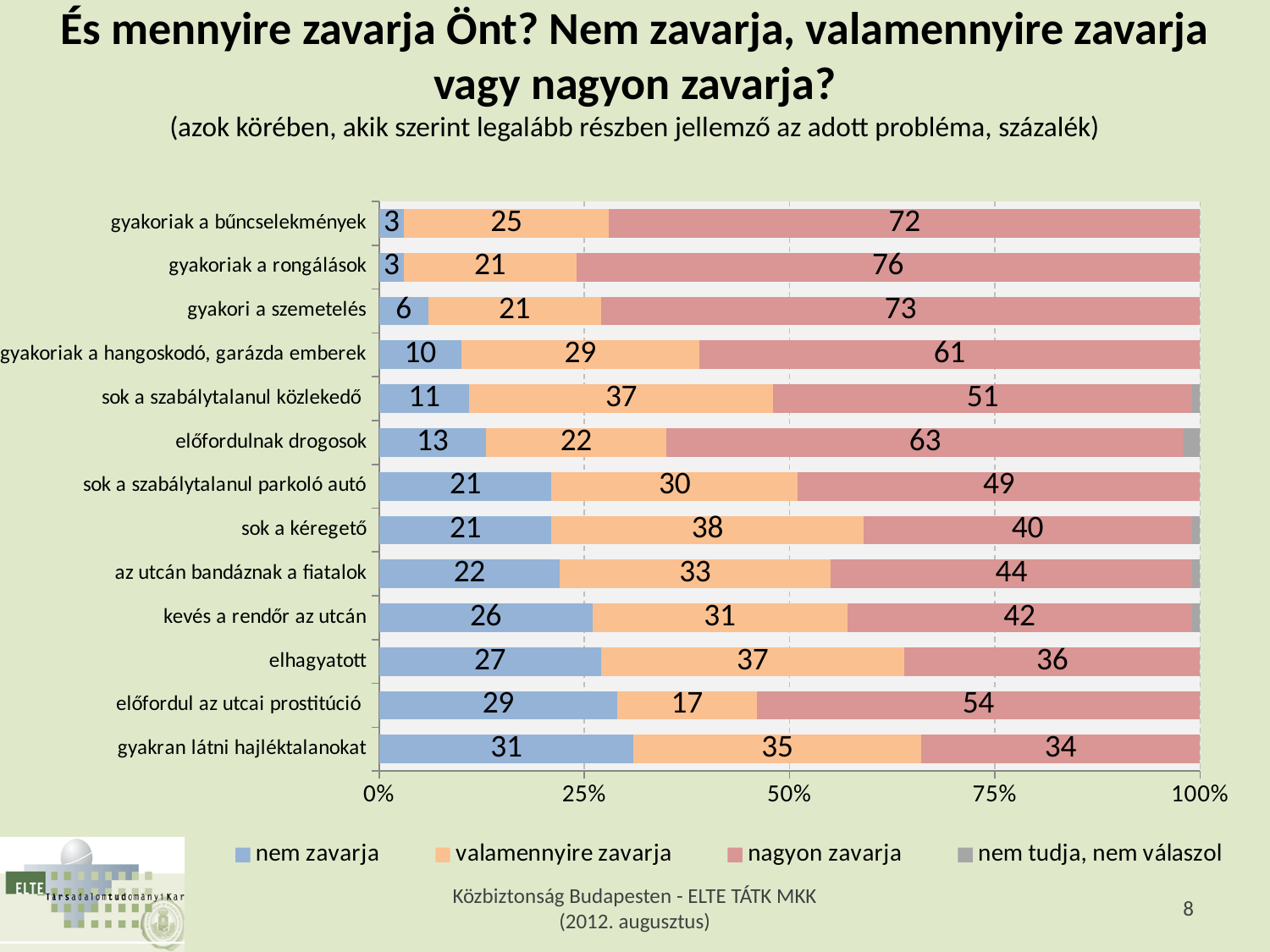
Which has the larger 'nem zavarja' value: 'elhagyatott' or 'előfordul az utcai prostitúció'? előfordul az utcai prostitúció Which category has the highest 'nagyon zavarja' value? gyakoriak a rongálások What is the difference between the 'nagyon zavarja' values for 'gyakoriak a bűncselekmények' and 'gyakran látni hajléktalanokat'? 38 How many series does the chart's legend list? 4 Which category has the highest 'nem zavarja' value? gyakran látni hajléktalanokat What is the 'nem zavarja' value for 'gyakran látni hajléktalanokat'? 31 What is the 'nagyon zavarja' value for 'gyakoriak a rongálások'? 76 What is the last entry listed in the chart's legend? nem tudja, nem válaszol What kind of chart is shown on the slide? stacked bar chart How many categories (problems) are listed on the vertical axis of the chart? 13 Which category has the lowest 'nagyon zavarja' value? gyakran látni hajléktalanokat What is the 'valamennyire zavarja' value for 'sok a kéregető'? 38